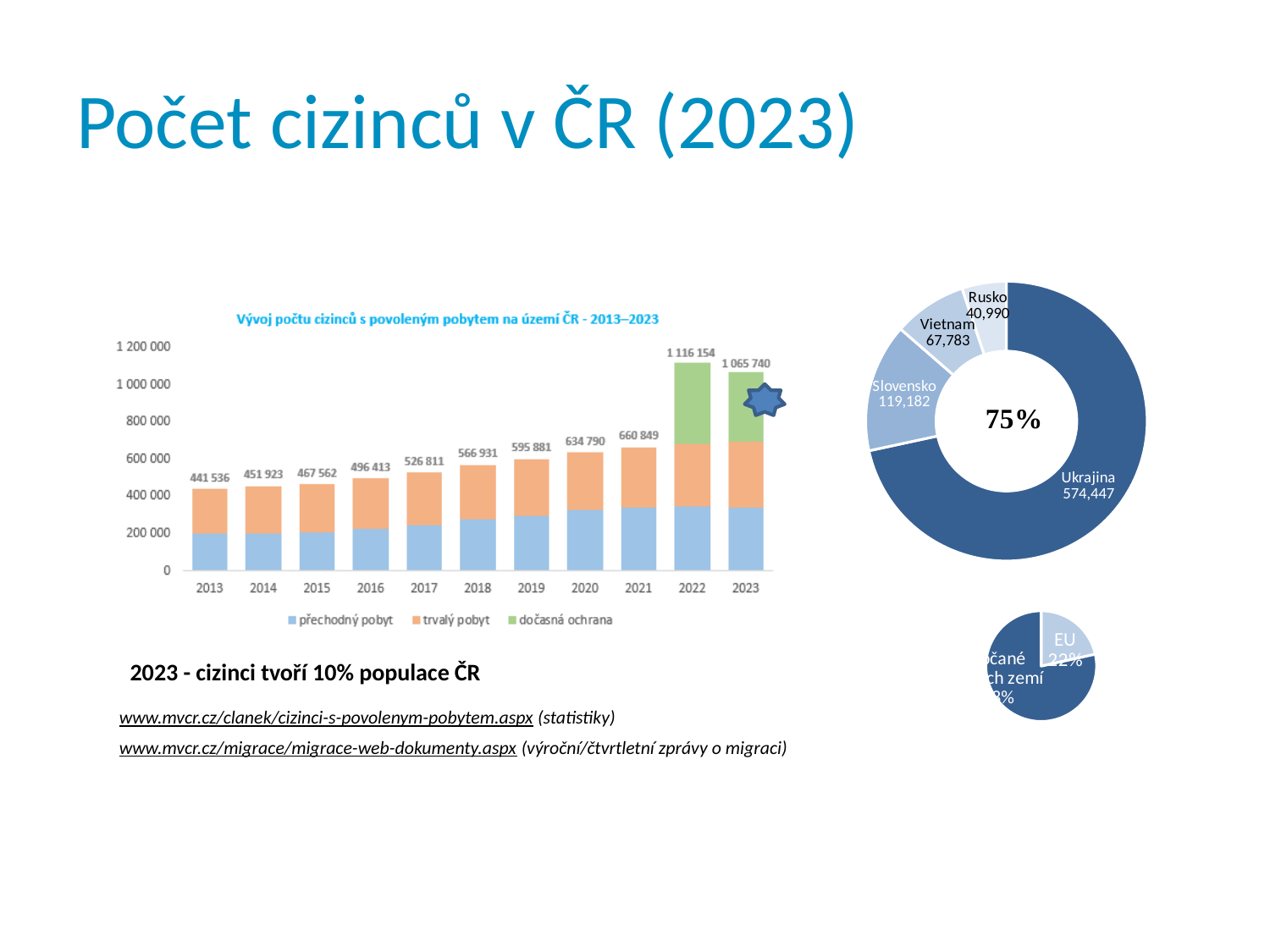
In the bar chart 'Vývoj počtu cizinců s povoleným pobytem na území ČR - 2013–2023', do the totals rise or fall from 2013 to 2021? Rise In the bar chart 'Vývoj počtu cizinců s povoleným pobytem na území ČR - 2013–2023', is the 'přechodný pobyt' segment for 2023 greater or less than 400 000? less In the bar chart 'Vývoj počtu cizinců s povoleným pobytem na území ČR - 2013–2023', what is the total number of foreigners shown for 2023? 1 065 740 In the small pie chart at the bottom right, what percentage is shown for EU? 22% In the bar chart 'Vývoj počtu cizinců s povoleným pobytem na území ČR - 2013–2023', which year has the lowest total? 2013 In the bar chart 'Vývoj počtu cizinců s povoleným pobytem na území ČR - 2013–2023', how many years are shown on the x axis? 11 In the bar chart 'Vývoj počtu cizinců s povoleným pobytem na území ČR - 2013–2023', how many series does the legend list? 3 In the bar chart 'Vývoj počtu cizinců s povoleným pobytem na území ČR - 2013–2023', what is the difference between the totals for 2022 and 2023? 50 414 In the bar chart 'Vývoj počtu cizinců s povoleným pobytem na území ČR - 2013–2023', which year has the highest total? 2022 What kind of chart is 'Vývoj počtu cizinců s povoleným pobytem na území ČR - 2013–2023'? Stacked bar chart In the donut chart on the right, what is the value for Ukrajina? 574,447 In the donut chart on the right, which country has the largest value? Ukrajina